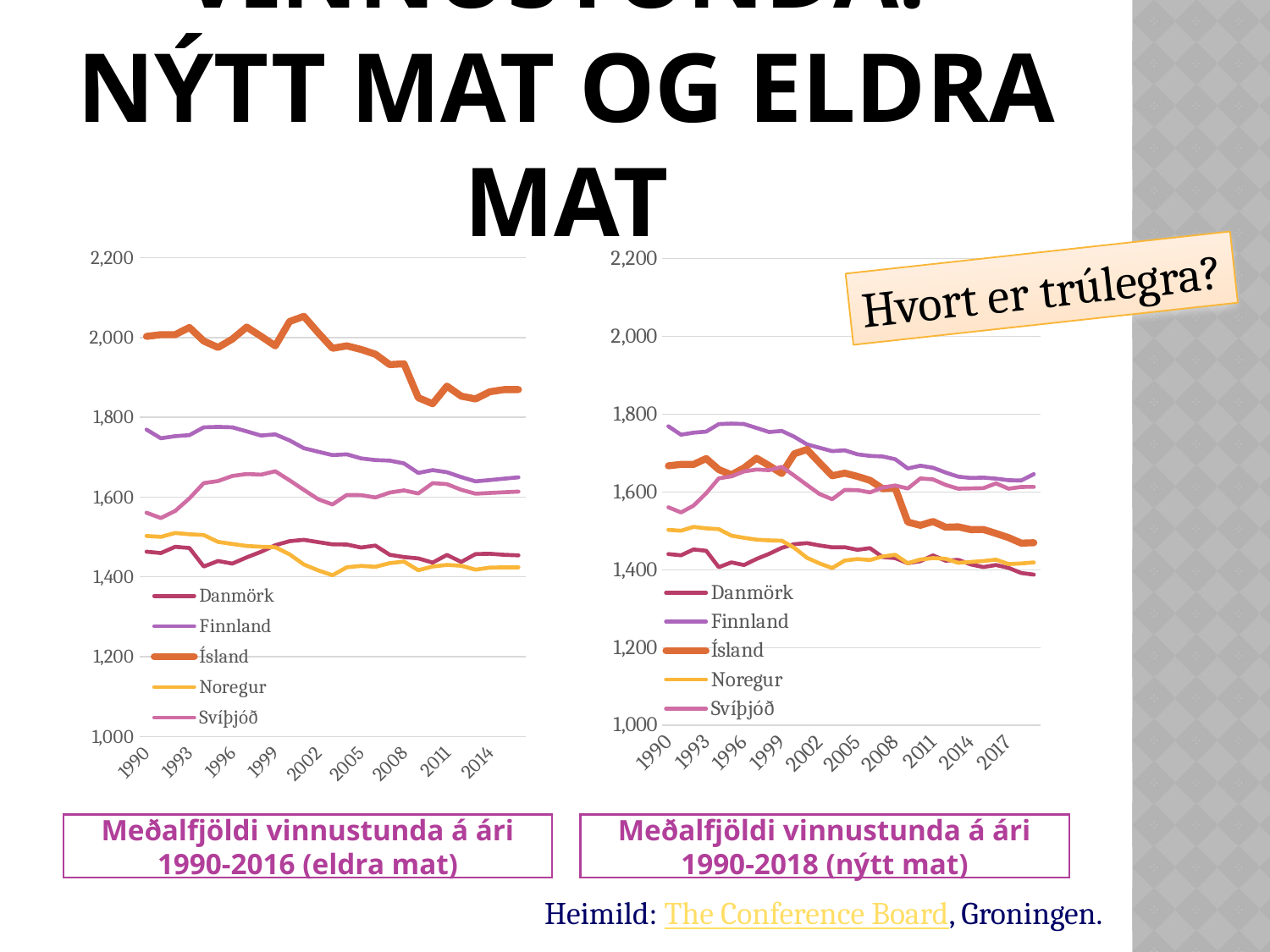
In the left chart (1990-2016, eldra mat), is the value for Ísland in 1990 greater or less than 1,800? greater In the right chart (1990-2018, nýtt mat), which country has the highest value in 1990? Finnland How many series does the legend of the left chart (1990-2016, eldra mat) list? 5 How many series does the legend of the right chart (1990-2018, nýtt mat) list? 5 In the left chart (1990-2016, eldra mat), which country has the highest value in 1990? Ísland In the left chart (1990-2016, eldra mat), which is higher in 1990: Finnland or Svíþjóð? Finnland In the right chart (1990-2018, nýtt mat), is the value for Finnland in 1990 greater or less than 1,600? greater In the right chart (1990-2018, nýtt mat), does the Finnland line rise or fall from 1990 to 2018? Falls What kind of chart is the left chart (Meðalfjöldi vinnustunda á ári 1990-2016 (eldra mat))? Line chart In the left chart (1990-2016, eldra mat), is the value for Noregur in 2016 greater or less than 1,600? less In the left chart (1990-2016, eldra mat), does the Ísland line rise or fall from 1990 to 2016? Falls